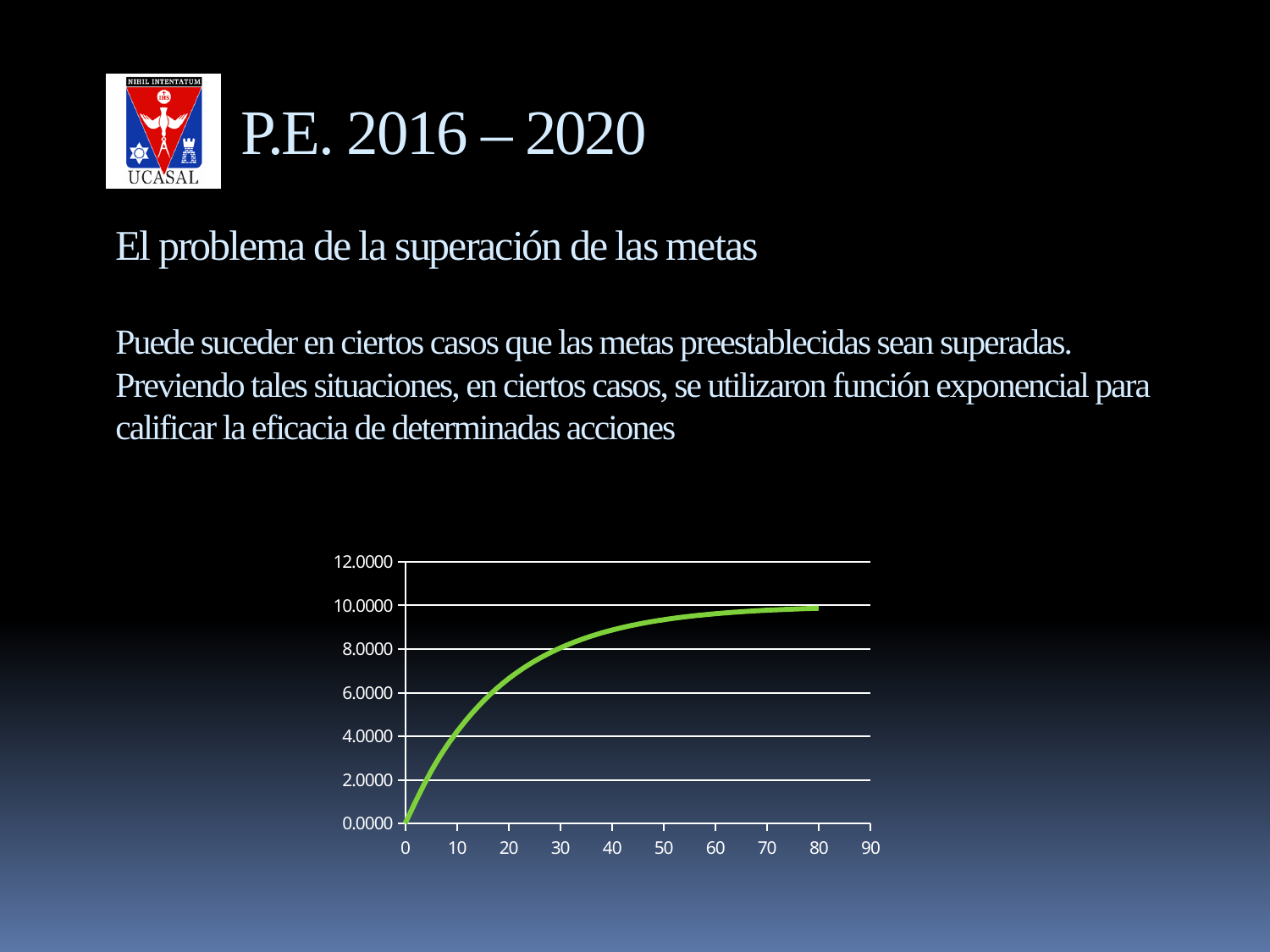
What is the plotted value at x = 0? 0.0000 Is the plotted value at x = 80 greater or less than 8.0000? greater How many lines are plotted on the chart? 1 Is the plotted value at x = 60 greater or less than 8.0000? greater What colour is the plotted line? green Is the plotted value at x = 10 greater or less than 2.0000? greater What kind of chart is shown on the slide? line chart Do the plotted values rise or fall as x increases from 0 to 80? rise What is the highest value labelled on the vertical axis? 12.0000 Which is larger, the plotted value at x = 20 or at x = 70? x = 70